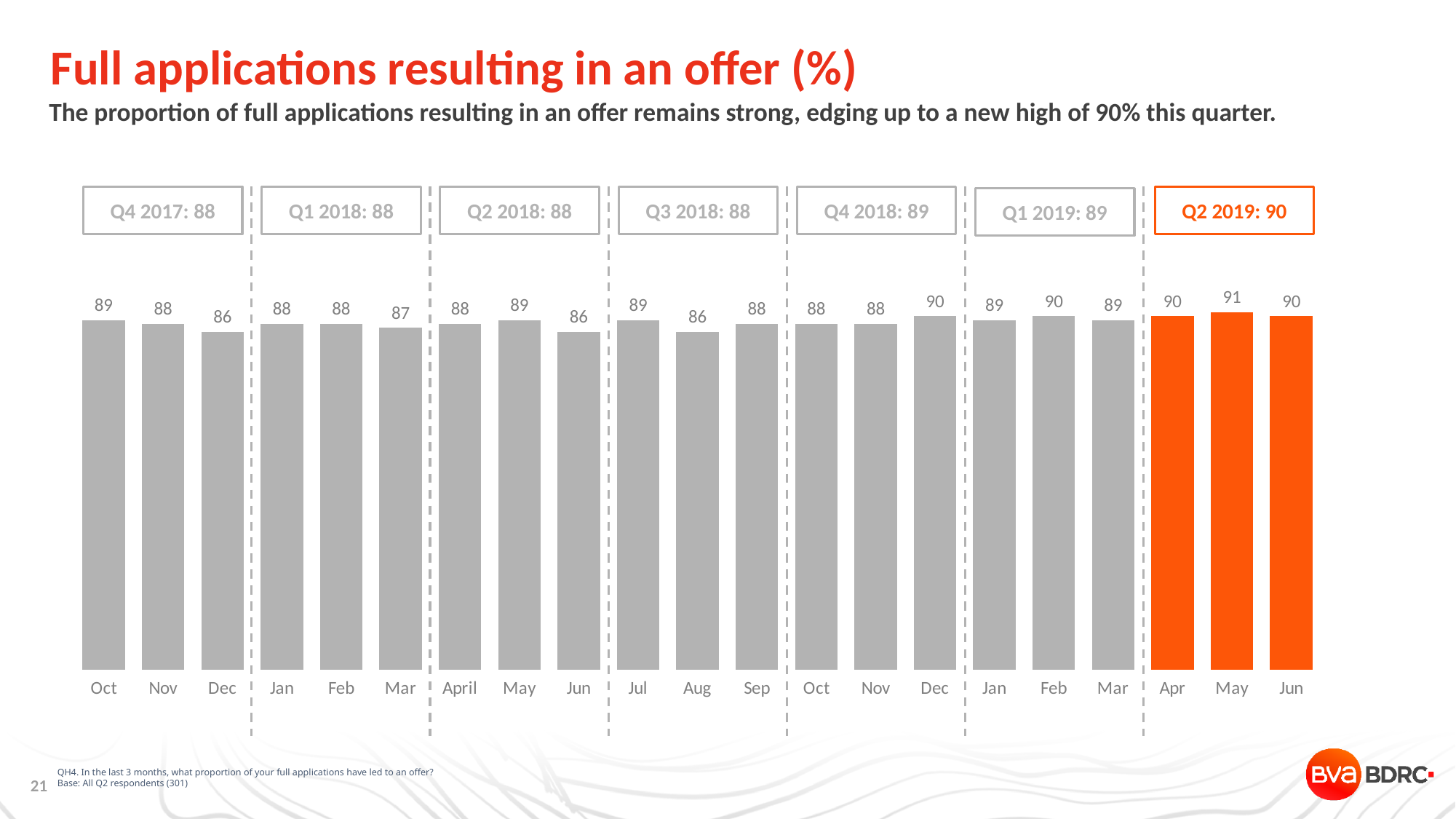
What type of chart is shown on the slide? bar chart What is the lowest value shown on any bar in the chart? 86 What is the value for Dec in Q4 2018? 90 What is the value for Dec in Q4 2017? 86 Which month has the highest value in the chart? May (Q2 2019) What is the difference between the value for May in Q2 2019 and the value for Aug in Q3 2018? 5 What is the value for May in Q2 2019? 91 How many monthly bars are plotted in the chart? 21 Which is larger, the value for Feb in Q1 2019 or the value for Mar in Q1 2019? Feb in Q1 2019 What quarterly value is shown in the box for Q2 2019? 90 Which quarter's bars are highlighted in orange? Q2 2019 What is the value for Mar in Q1 2018? 87